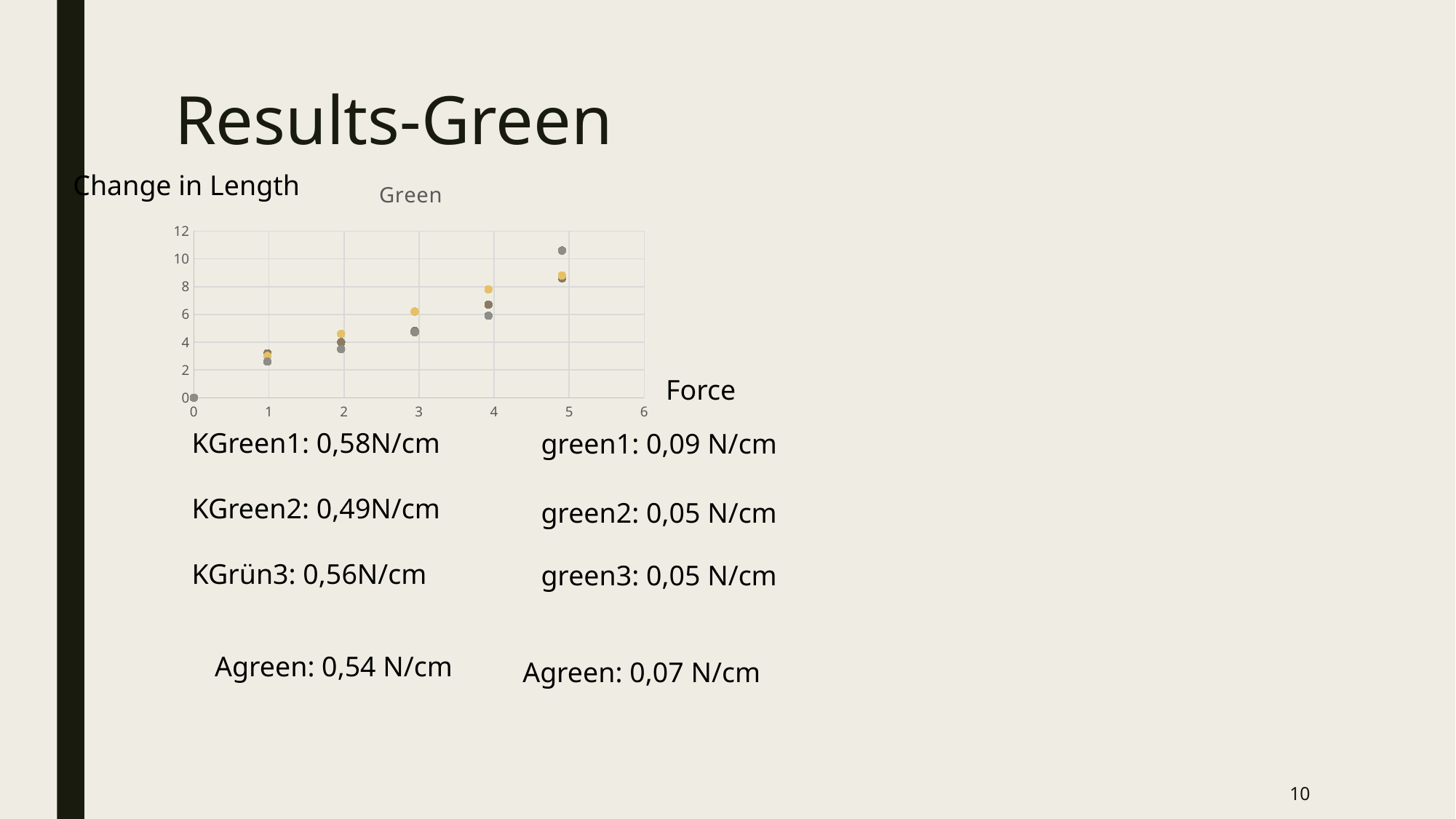
What is the title of the chart? Green Are the plotted values at Force 3 greater or less than 8? less Are the plotted values at Force 5 greater or less than 8? greater Are the plotted values at Force 3 greater or less than 4? greater What label is shown next to the horizontal axis of the chart? Force What kind of chart is shown on the slide? scatter chart At which Force value are the plotted points highest? 5 Do the plotted values rise or fall as Force increases along the x axis? rise